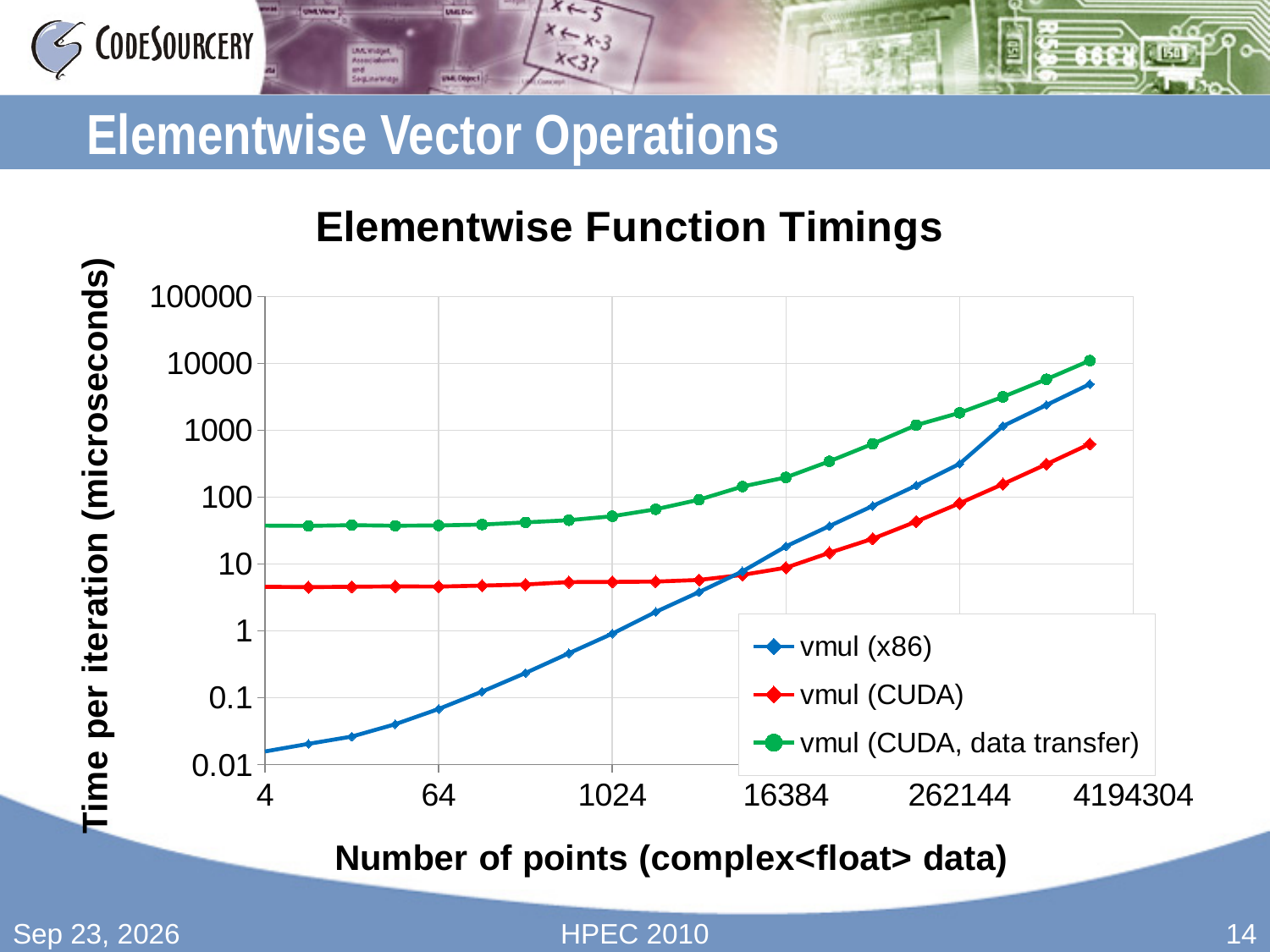
What is the label of the x axis? Number of points (complex<float> data) Is the value for vmul (CUDA, data transfer) at 4 points greater or less than 10? greater Is the value for vmul (x86) at the right end of the x axis greater or less than 1000? greater Is the value for vmul (x86) at 4 points greater or less than 0.1? less Does the vmul (x86) series rise or fall as the number of points increases? rise At the right end of the x axis, which series has the higher value, vmul (x86) or vmul (CUDA)? vmul (x86) Which series has the highest value at 4 points? vmul (CUDA, data transfer) How many series does the legend list? 3 At 4 points, which series has the higher value, vmul (x86) or vmul (CUDA)? vmul (CUDA) What kind of chart is shown on the slide? Line chart What is the title of the chart? Elementwise Function Timings